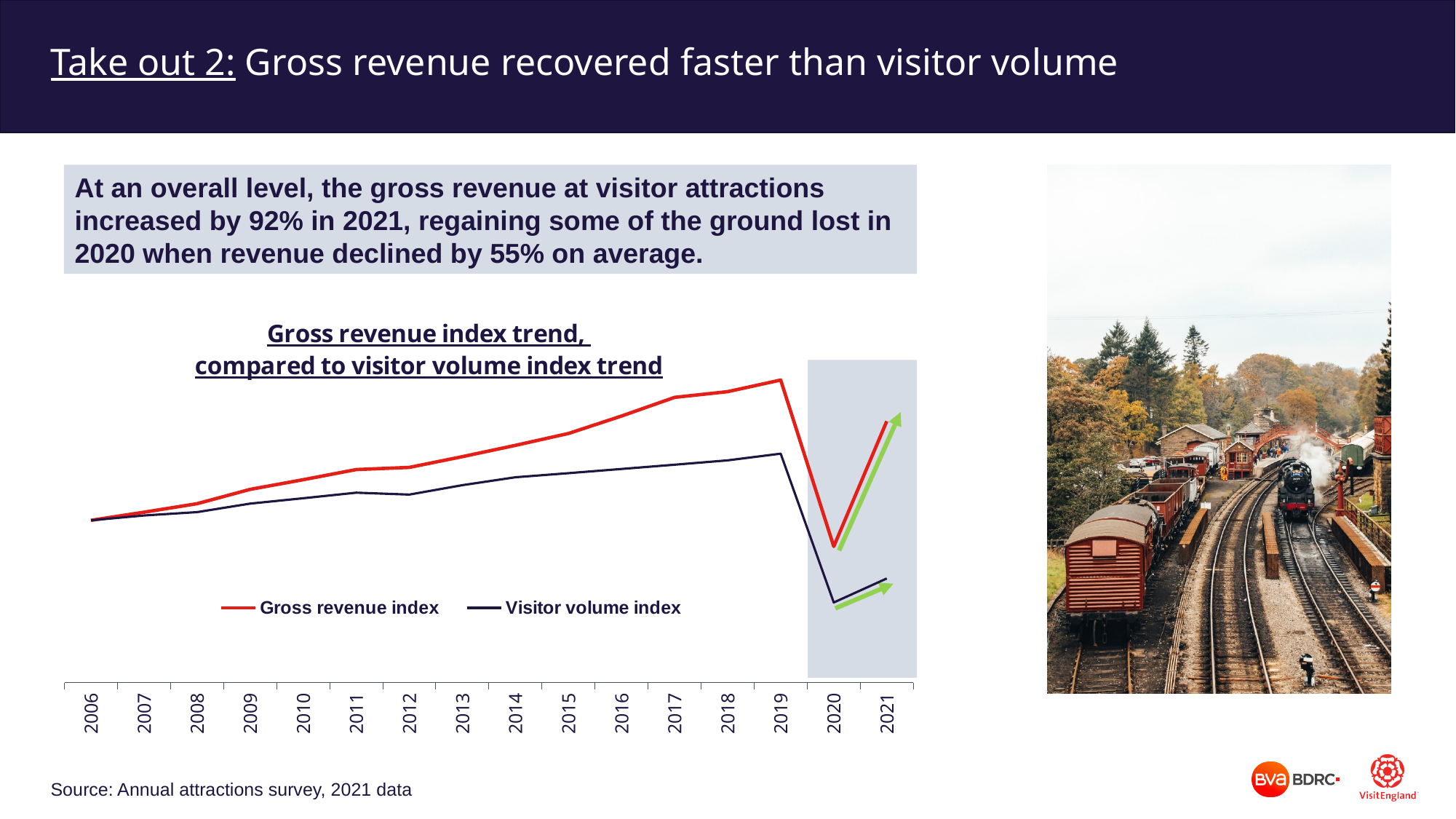
Does the Gross revenue index generally rise or fall from 2006 to 2019? Rise Which colour is used for the Gross revenue index line? Red In which year does the Gross revenue index reach its highest point? 2019 In which year does the Gross revenue index reach its lowest point? 2020 In which year does the Visitor volume index reach its lowest point? 2020 In 2019, which series is higher: Gross revenue index or Visitor volume index? Gross revenue index How many series does the chart's legend list? 2 What kind of chart is shown on the slide? Line chart Does the Visitor volume index rise or fall from 2019 to 2020? Fall How many years are shown along the x axis of the chart? 16 In 2021, which series is higher: Gross revenue index or Visitor volume index? Gross revenue index In which year does the Visitor volume index reach its highest point? 2019